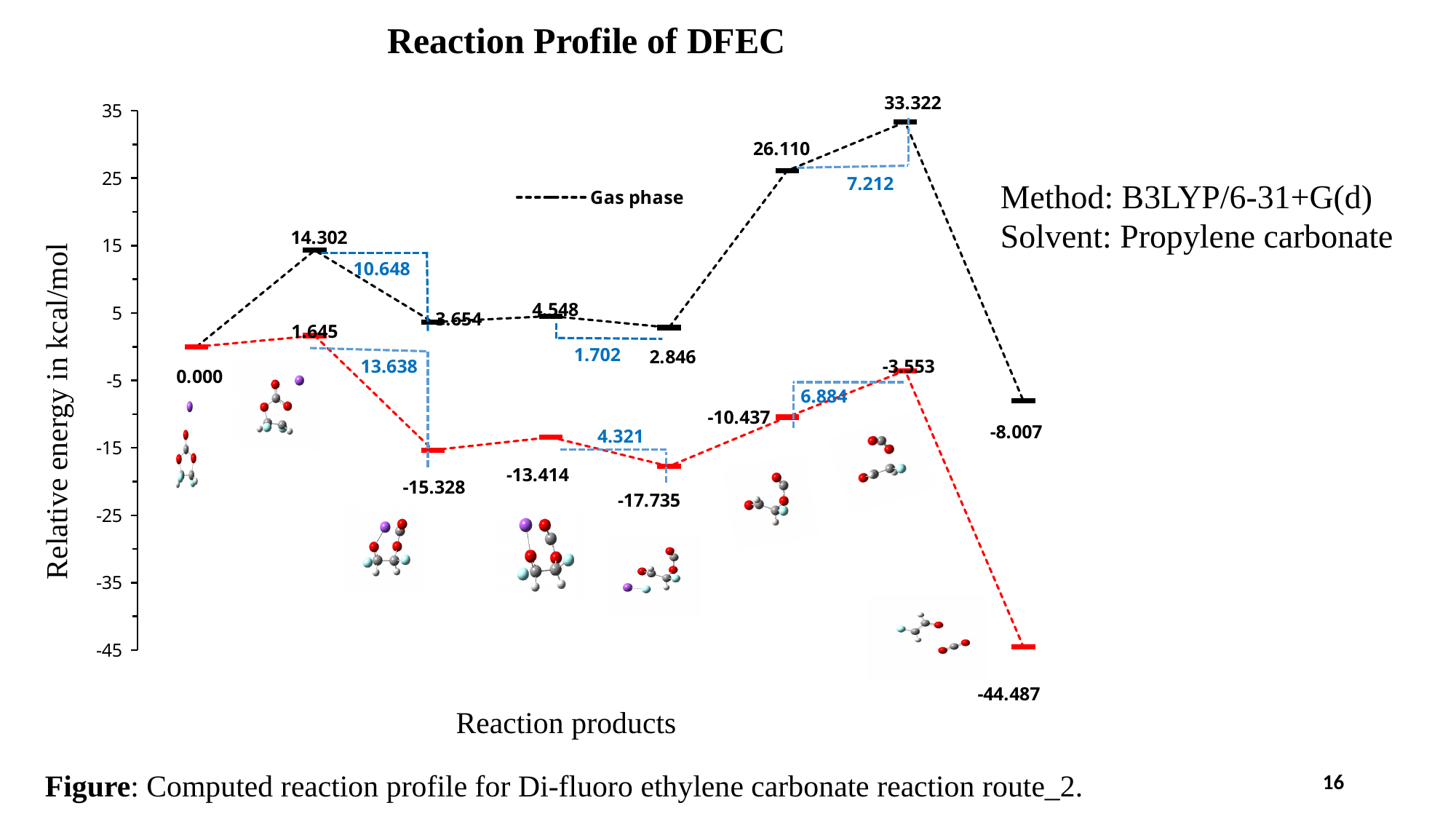
What is the lowest value reached by the red dashed series? -44.487 What is the title of the chart? Reaction Profile of DFEC How many series does the chart legend list? 1 How many data points are plotted for the Gas phase series? 8 What is the difference between the two highest Gas phase values, 33.322 and 26.110? 7.212 What is the highest value reached by the red dashed series? 1.645 What is the highest value reached by the Gas phase series? 33.322 Which series ends at a higher value on the right of the chart, the Gas phase series or the red dashed series? Gas phase What kind of chart is shown on the slide? line chart What is the label of the vertical axis? Relative energy in kcal/mol What is the final (rightmost) value of the Gas phase series? -8.007 What is the lowest value reached by the Gas phase series? -8.007